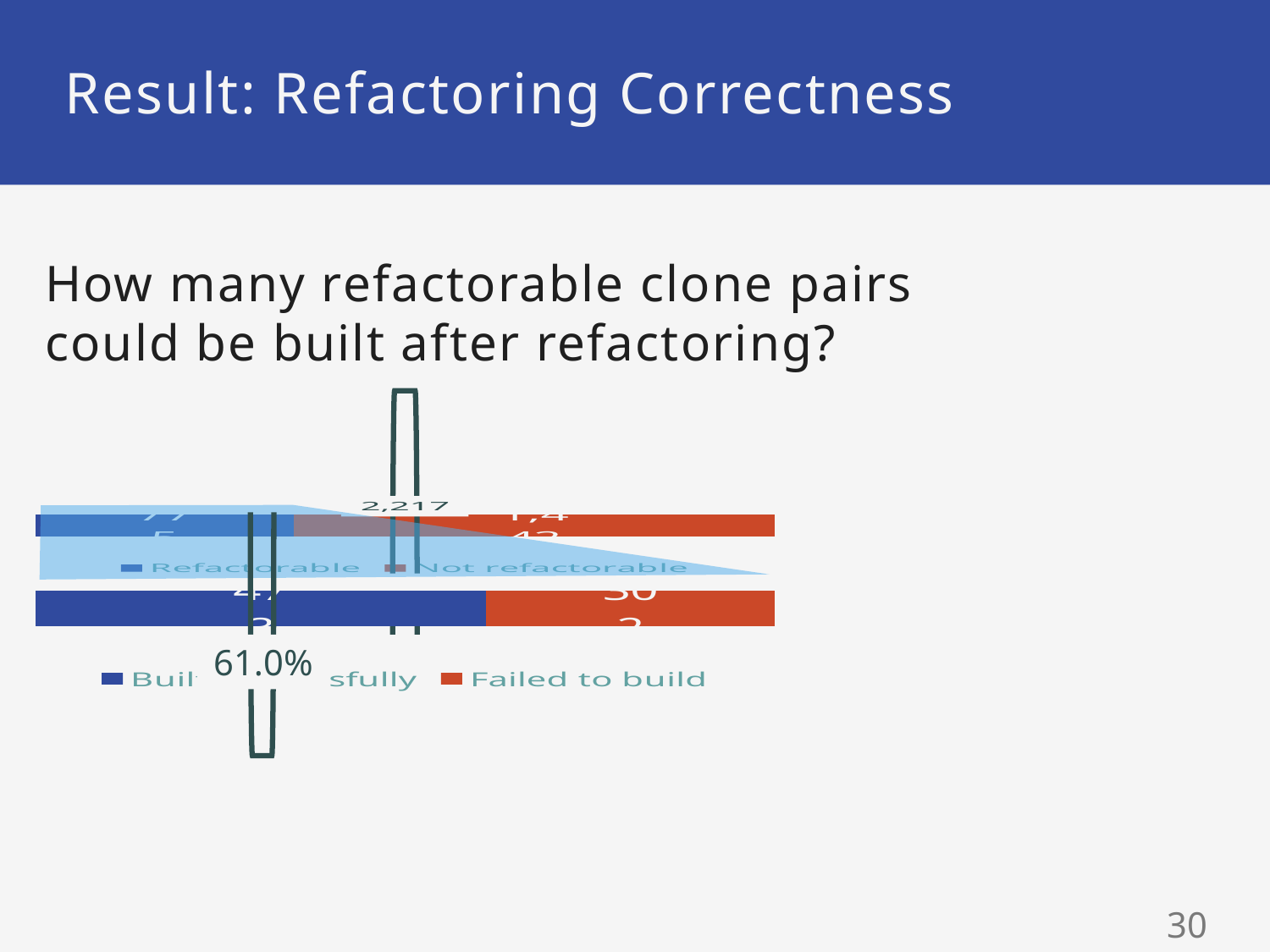
In the top chart, how many series does the legend list? 2 In the top chart, what is the second legend entry after 'Refactorable'? Not refactorable In the bottom chart, how many series does the legend list? 2 In the top chart, what colour represents 'Refactorable'? blue What kind of chart is the top chart (with the legend 'Refactorable' and 'Not refactorable')? bar chart In the bottom chart, what colour represents 'Failed to build'? red What kind of chart is the bottom chart (with the legend 'Failed to build')? bar chart In the bottom chart, which segment is larger: the blue 'Built successfully' segment or the red 'Failed to build' segment? Built successfully